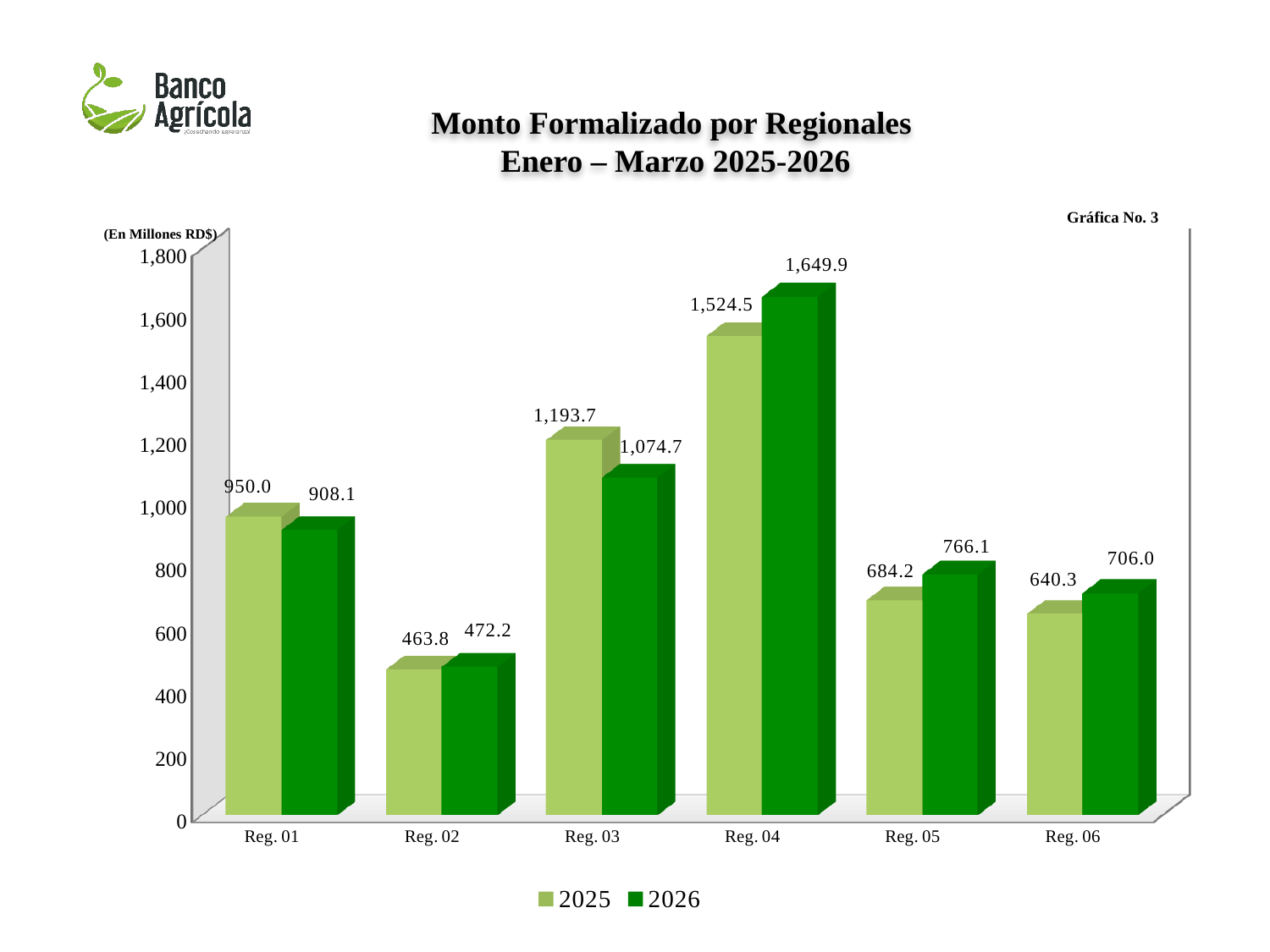
Which region has the highest value in the 2025 series? Reg. 04 What is the value for Reg. 04 in the 2026 series? 1,649.9 What is the value for Reg. 02 in the 2025 series? 463.8 What is the difference between the 2026 and 2025 values for Reg. 04? 125.4 How many regions are shown on the x axis? 6 Which region has the lowest value in the 2026 series? Reg. 02 What kind of chart is shown on the slide? bar chart Is the 2026 value for Reg. 05 greater or less than 800? less What is the difference between the 2025 and 2026 values for Reg. 03? 119.0 What is the value for Reg. 06 in the 2026 series? 706.0 How many series does the legend list? 2 Which is larger for Reg. 01, the 2025 value or the 2026 value? 2025